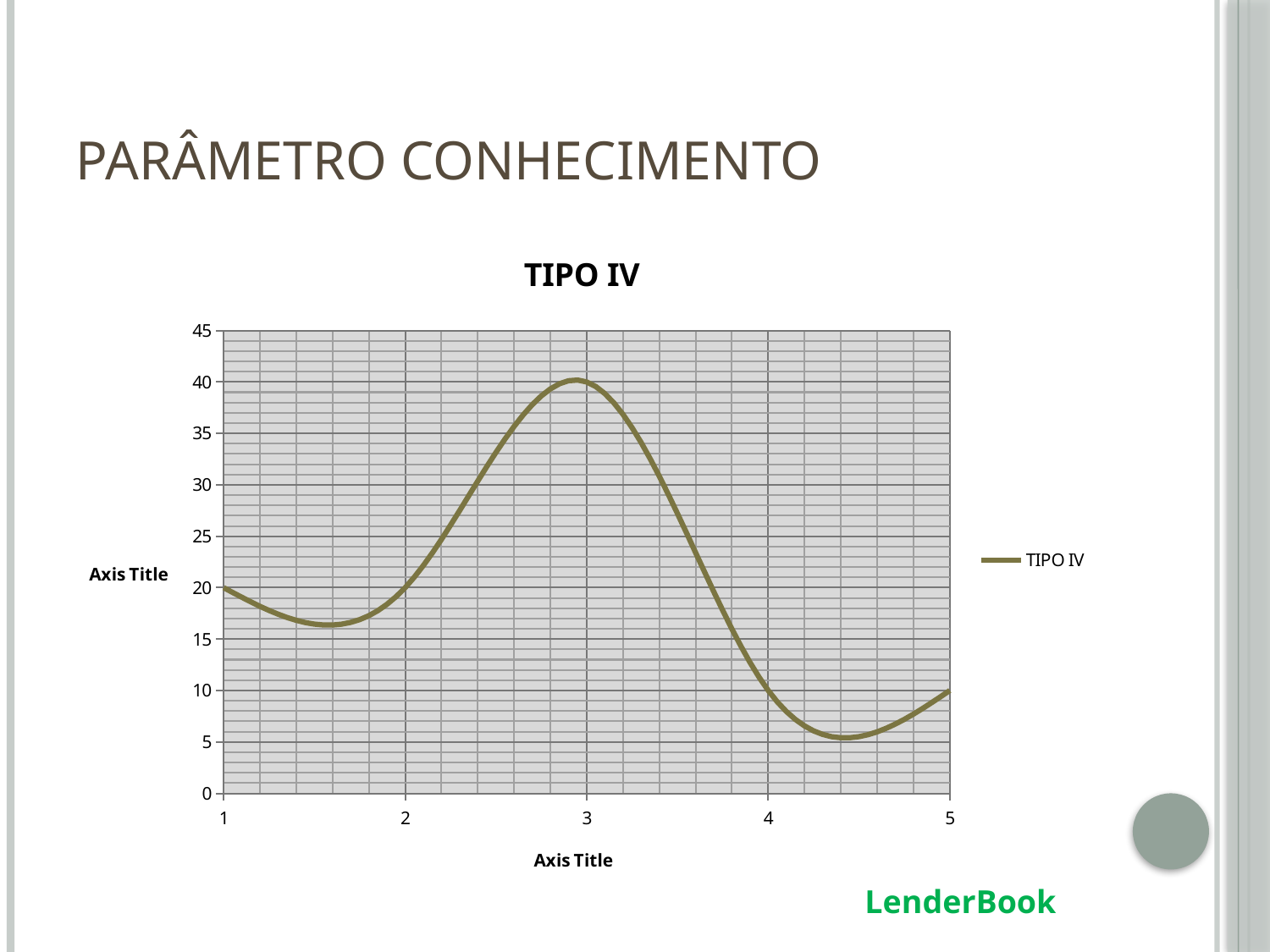
At which x-axis value does the TIPO IV line reach its highest value? 3 What kind of chart is shown on the slide? line chart What is the title of the chart? TIPO IV What is the value of TIPO IV at x = 1? 20 Is the value of TIPO IV at x = 3 greater or less than 35? greater How many series does the legend list? 1 Does the TIPO IV line rise or fall between x = 2 and x = 3? rise How many x-axis categories are shown on the chart? 5 Which is larger, the value of TIPO IV at x = 3 or at x = 4? x = 3 Is the value of TIPO IV at x = 2 greater or less than 25? less Does the TIPO IV line rise or fall between x = 3 and x = 4? fall Is the value of TIPO IV at x = 4 greater or less than 15? less